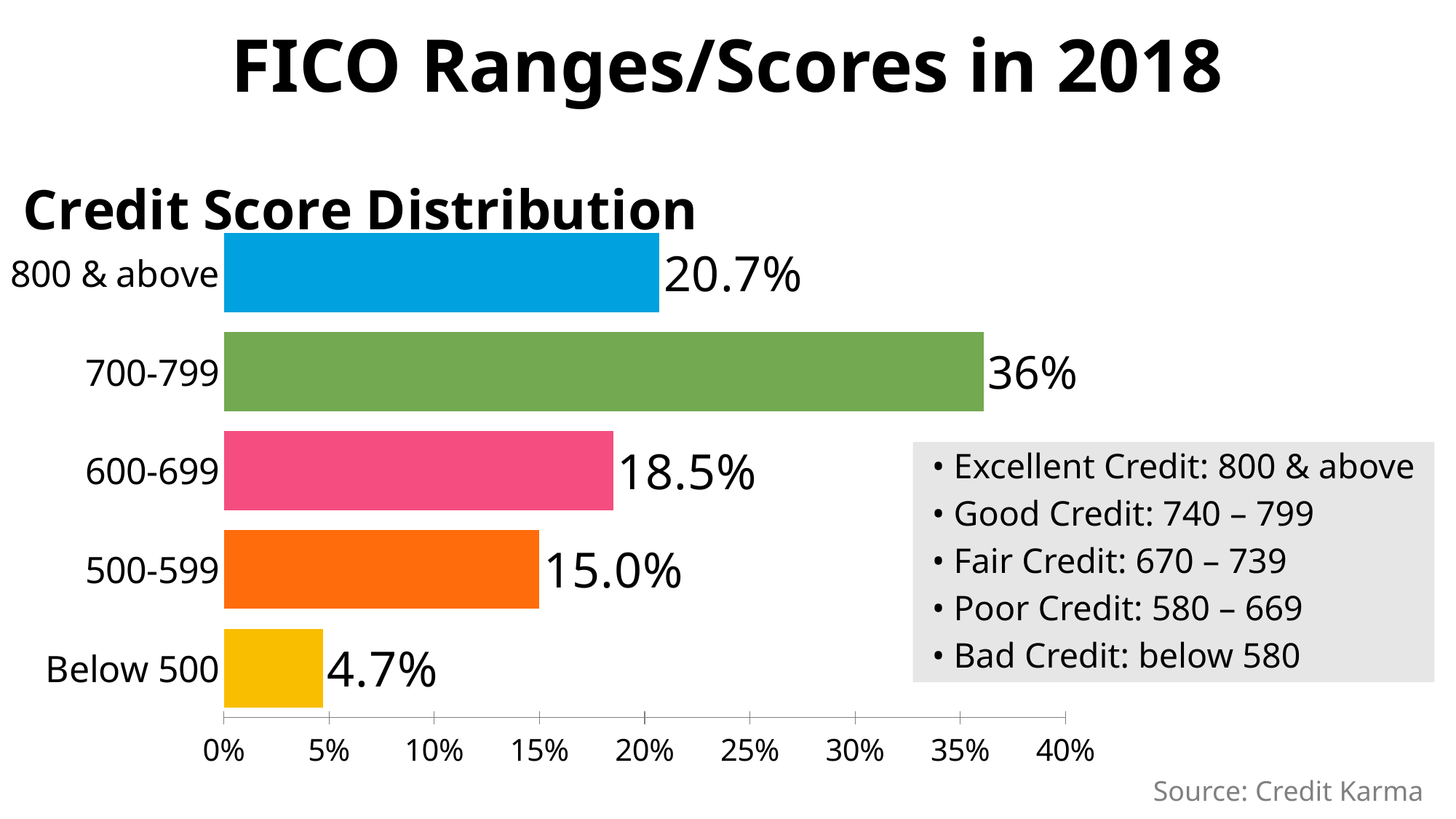
What is the difference between the 700-799 and 800 & above values? 15.3% Which credit score range has the highest share? 700-799 Which credit score range has the lowest share? Below 500 Which is larger, the value for 600-699 or the value for 500-599? 600-699 What percentage of credit scores fall in the 700-799 range? 36% What percentage is shown for the Below 500 category? 4.7% What is the title of the chart? Credit Score Distribution Is the value for 700-799 greater or less than 35%? greater What is the difference between the 600-699 and 500-599 values? 3.5% How many credit score categories are shown in the chart? 5 What kind of chart is shown on the slide? Bar chart What is the value shown for the 800 & above category? 20.7%